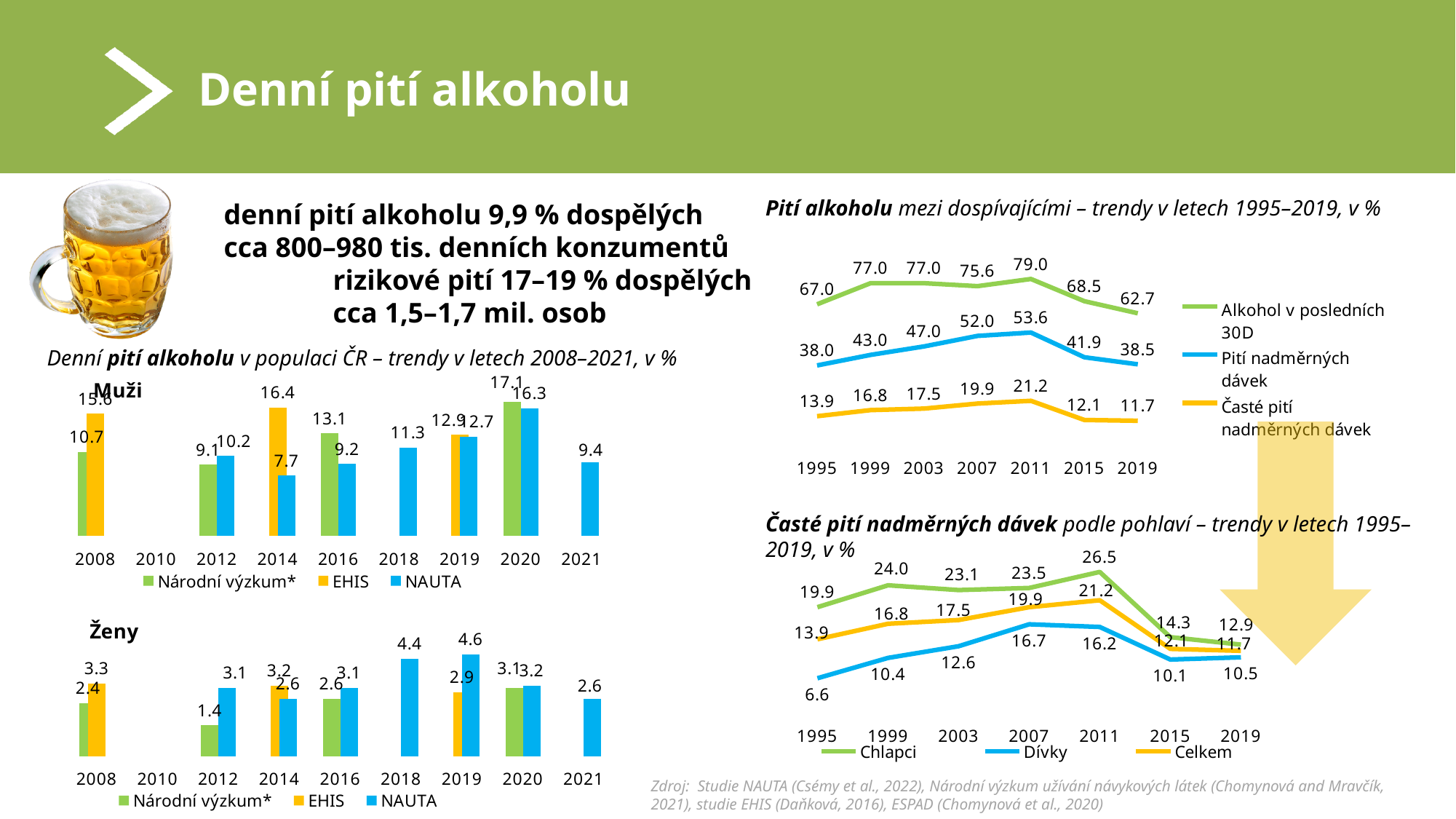
In the 'Časté pití nadměrných dávek podle pohlaví' chart, what is the Dívky value for 1995? 6.6 In the 'Pití alkoholu mezi dospívajícími' chart, in which year is 'Pití nadměrných dávek' highest? 2011 In the 'Muži' bar chart, what is the NAUTA value for 2021? 9.4 In the 'Muži' bar chart, what is the difference between the Národní výzkum* value and the NAUTA value in 2020? 0.8 In the 'Pití alkoholu mezi dospívajícími' chart, what is the value of 'Alkohol v posledních 30D' in 2011? 79.0 In the 'Časté pití nadměrných dávek podle pohlaví' chart, which is larger in 2019, Chlapci or Dívky? Chlapci In the 'Pití alkoholu mezi dospívajícími' chart, how many years are shown on the x axis? 7 What kind of chart is the 'Pití alkoholu mezi dospívajícími' chart? line chart In the 'Ženy' bar chart, which year has the highest NAUTA value? 2019 How many series does the legend of the 'Ženy' bar chart list? 3 In the 'Ženy' bar chart, what is the Národní výzkum* value for 2012? 1.4 In the 'Muži' bar chart, what is the EHIS value for 2014? 16.4